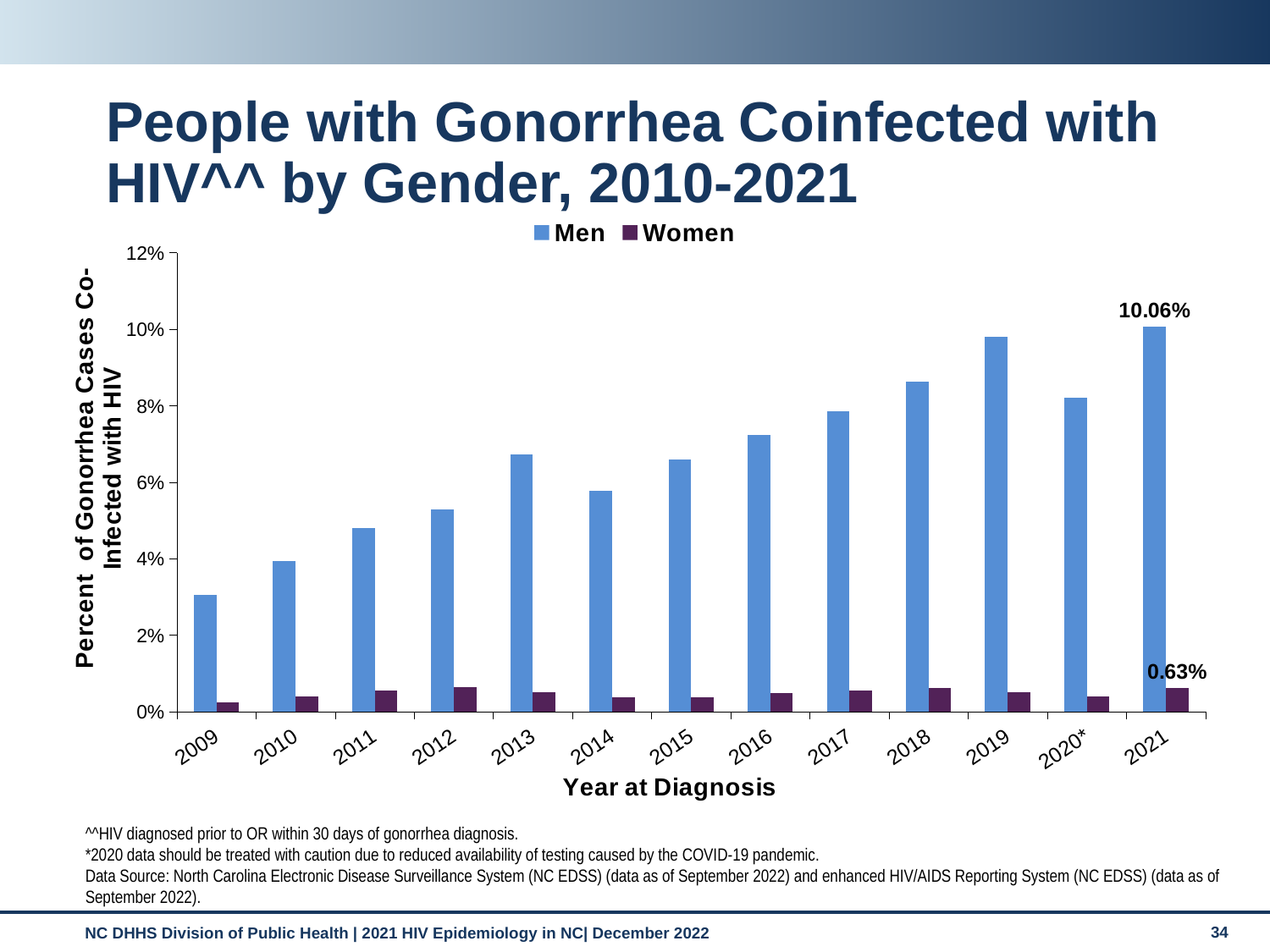
Is the value for Men in 2009 greater or less than 4%? less How many years are shown on the x axis? 13 How many series does the legend list? 2 What kind of chart is shown on the slide? Bar chart Do the Men values generally rise or fall from 2009 to 2021? Rise What is the value for Women in 2021? 0.63% Which year has the larger Men value, 2019 or 2020*? 2019 In which year is the Men value highest? 2021 In which year is the Men value lowest? 2009 What is the value for Men in 2021? 10.06% Is the value for Men in 2018 greater or less than 8%? greater What is the difference between the Men and Women values in 2021? 9.43%